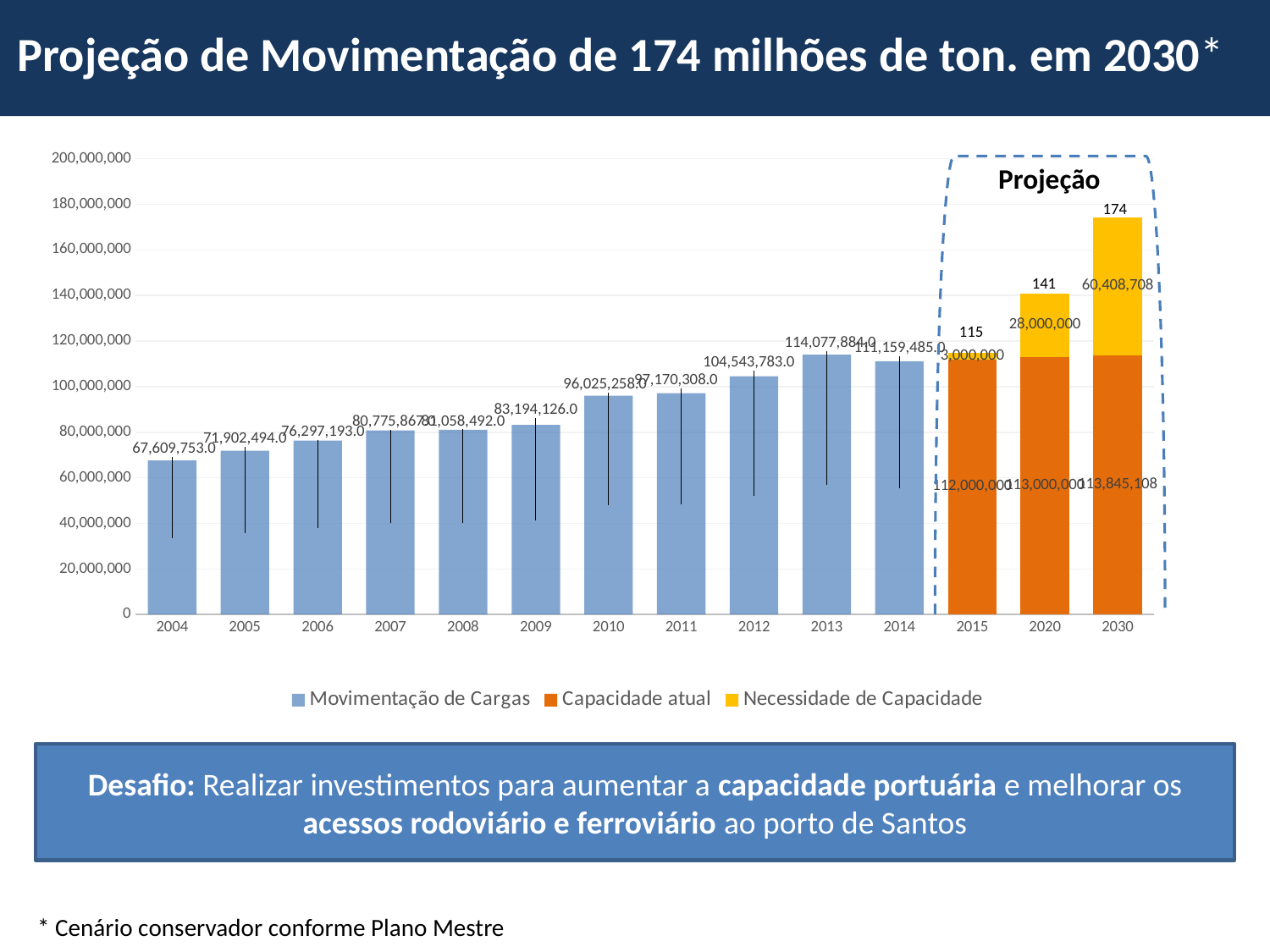
Which year has the larger Movimentação de Cargas value, 2013 or 2014? 2013 What is the value of Movimentação de Cargas for 2012? 104,543,783.0 What is the value of Movimentação de Cargas for 2004? 67,609,753.0 What is the Capacidade atual value for 2020? 113,000,000 How many series does the legend list? 3 Is the value for 2006 greater or less than 80,000,000? less Which year has the lowest Movimentação de Cargas value? 2004 What is the difference between the Necessidade de Capacidade values for 2020 and 2015? 25,000,000 What is the Necessidade de Capacidade value for 2030? 60,408,708 Which year has the tallest bar in the chart? 2030 How many years are shown on the x axis? 14 What label is printed at the top of the stacked bar for 2020? 141